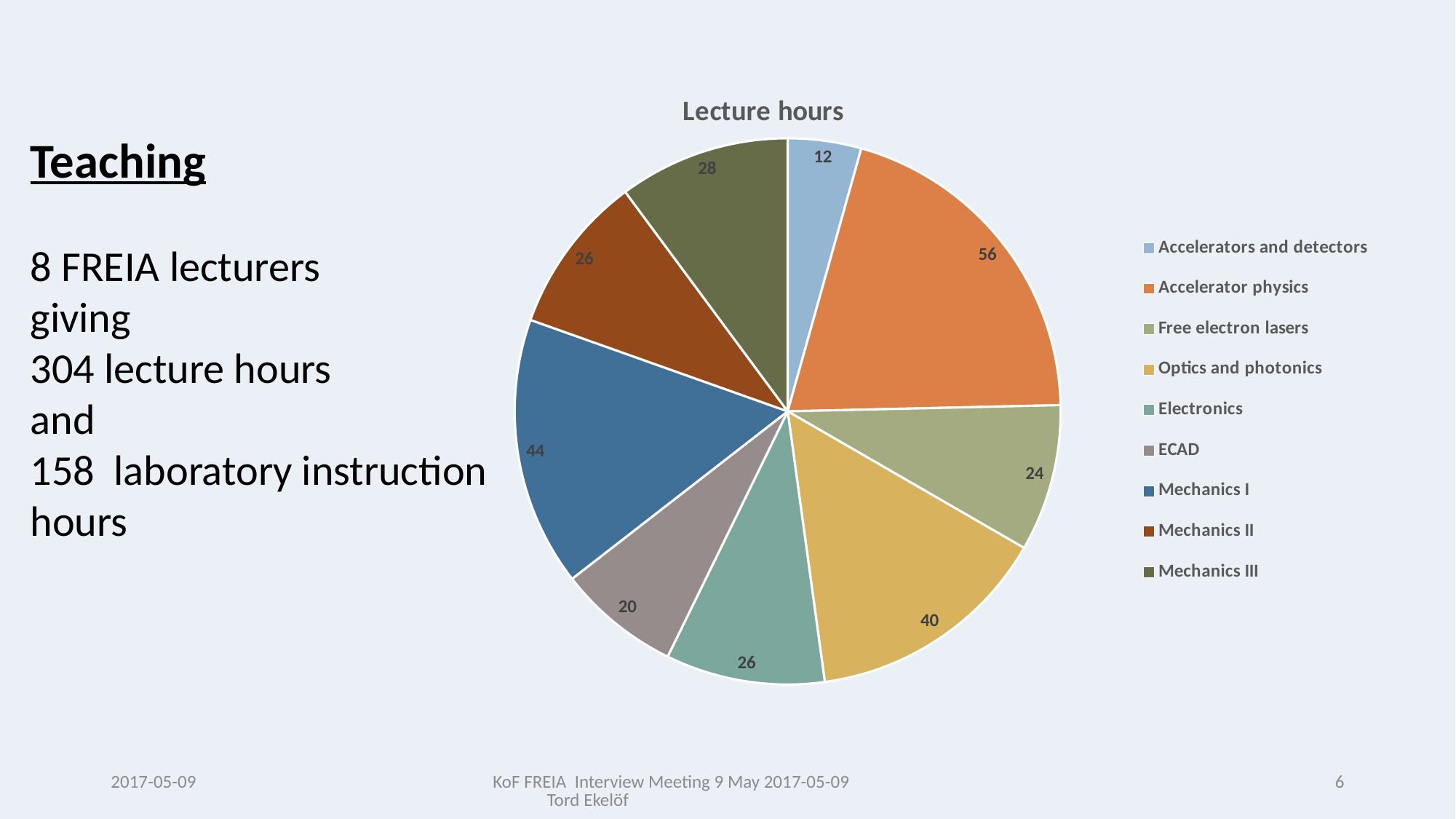
How many lecture hours are shown for Mechanics I? 44 What kind of chart is shown on the slide? pie chart How many categories does the legend list? 9 How many lecture hours are shown for ECAD? 20 How many lecture hours are shown for Optics and photonics? 40 What is the title of the chart? Lecture hours Which has more lecture hours, Free electron lasers or Mechanics III? Mechanics III What is the difference in lecture hours between Accelerator physics and Mechanics I? 12 What is the total of all the lecture hours shown in the pie chart? 276 Which category has the largest slice of the pie? Accelerator physics How many lecture hours are shown for Accelerator physics? 56 Which category has the smallest slice of the pie? Accelerators and detectors